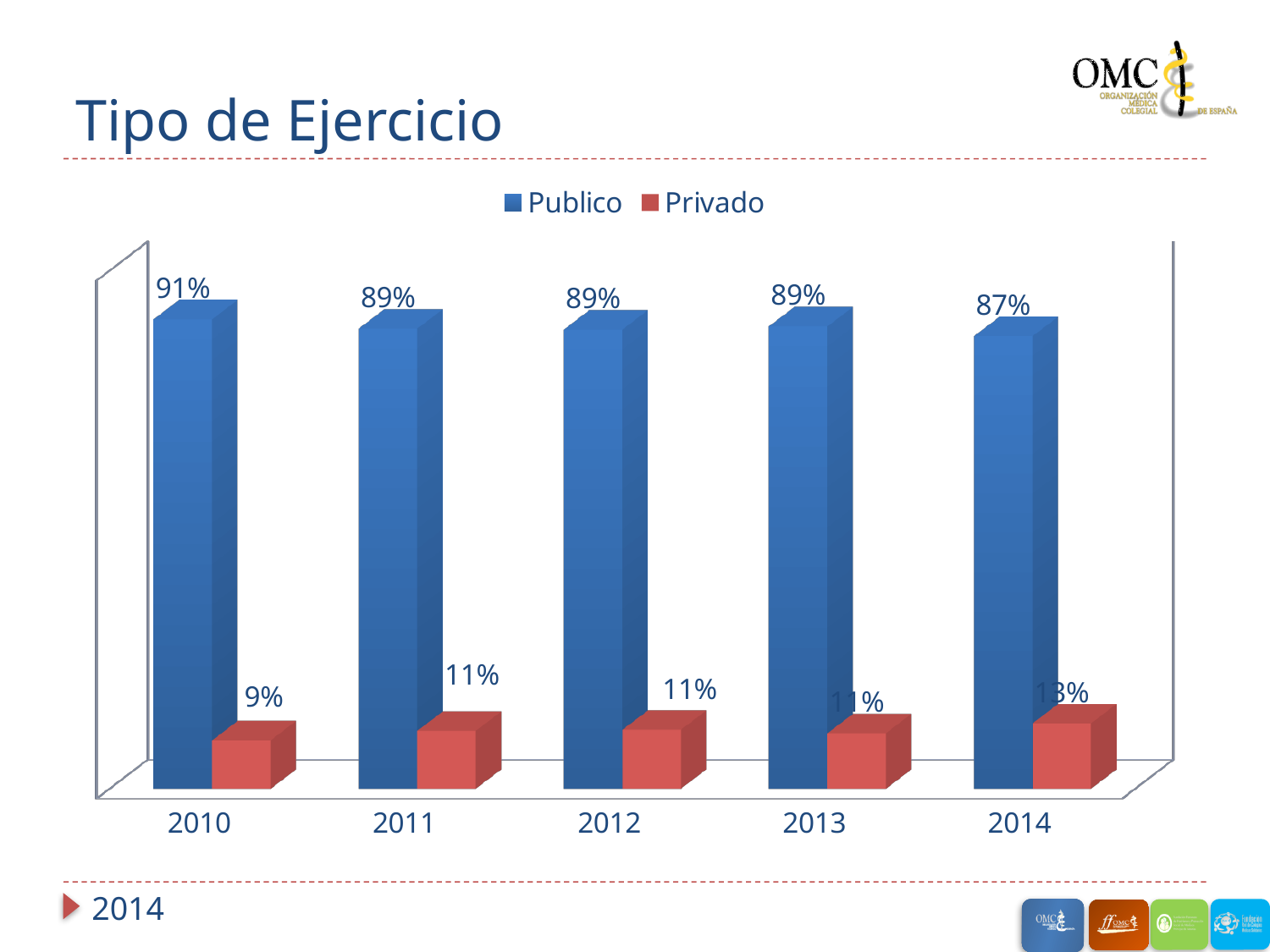
Which is larger in 2014, the Publico value or the Privado value? Publico What is the value for Publico in 2014? 87% In which year is the Publico value highest? 2010 Does the Privado value rise or fall from 2010 to 2014? Rise How many series does the legend list? 2 What kind of chart is shown on the slide? Bar chart What is the value for Privado in 2014? 13% How many years are shown on the x axis? 5 In which year is the Privado value lowest? 2010 What is the value for Privado in 2011? 11% What is the value for Publico in 2010? 91% What is the difference between the Publico and Privado values in 2010? 82%